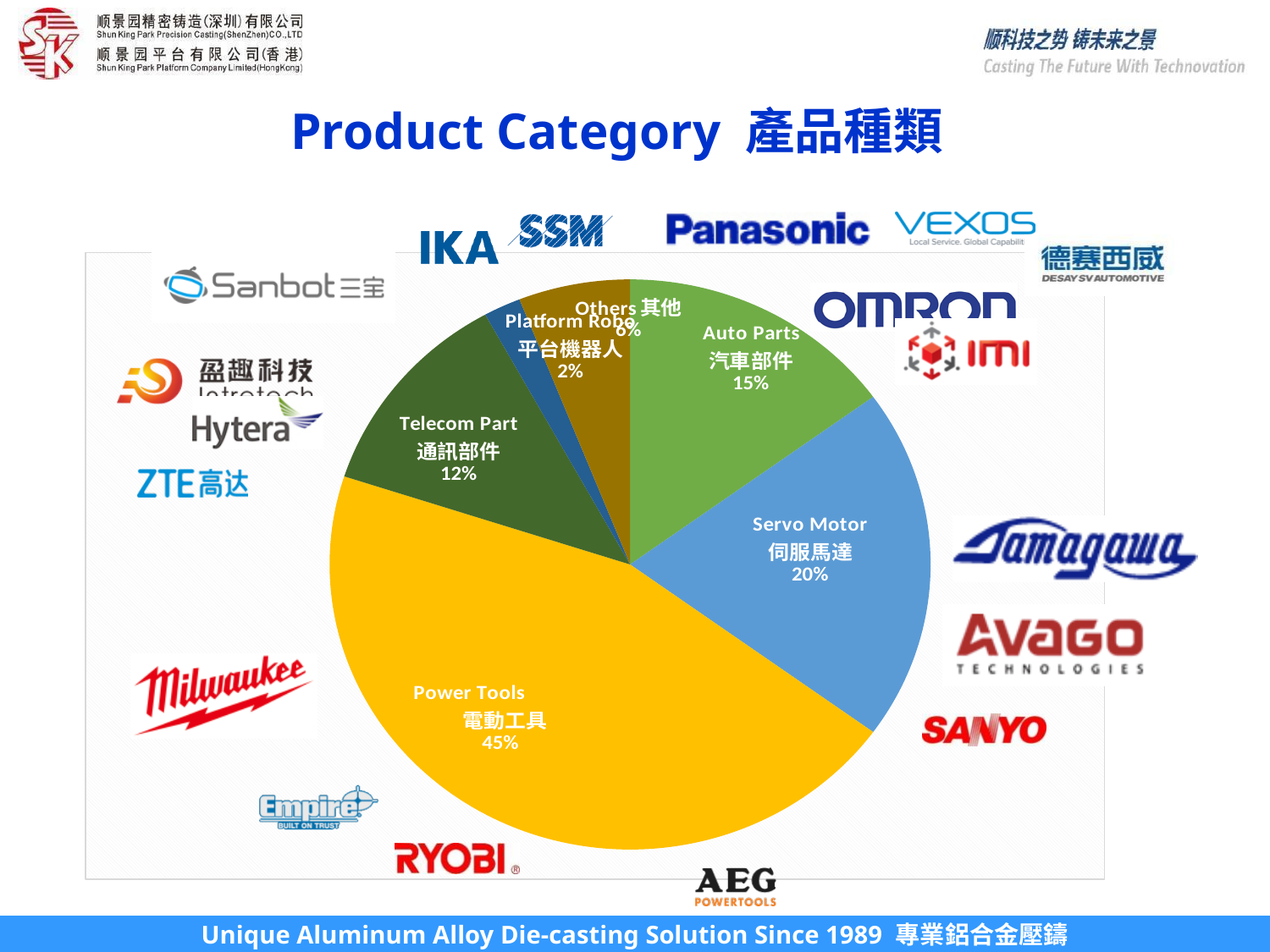
What percentage is shown for Auto Parts (汽車部件)? 15% What percentage is shown for Telecom Part (通訊部件)? 12% What kind of chart is shown on the slide? Pie chart How many product categories are shown in the pie chart? 6 What percentage is shown for Others (其他)? 6% What percentage is shown for Servo Motor (伺服馬達)? 20% What share of the pie does Power Tools (電動工具) have? 45% How many percentage points larger is the Power Tools share than the Servo Motor share? 25 percentage points Which product category has the largest slice of the pie? Power Tools What is the title of the slide containing the pie chart? Product Category 產品種類 Which has a larger share, Auto Parts or Telecom Part? Auto Parts Which product category has the smallest slice of the pie? Platform Robo (平台機器人)